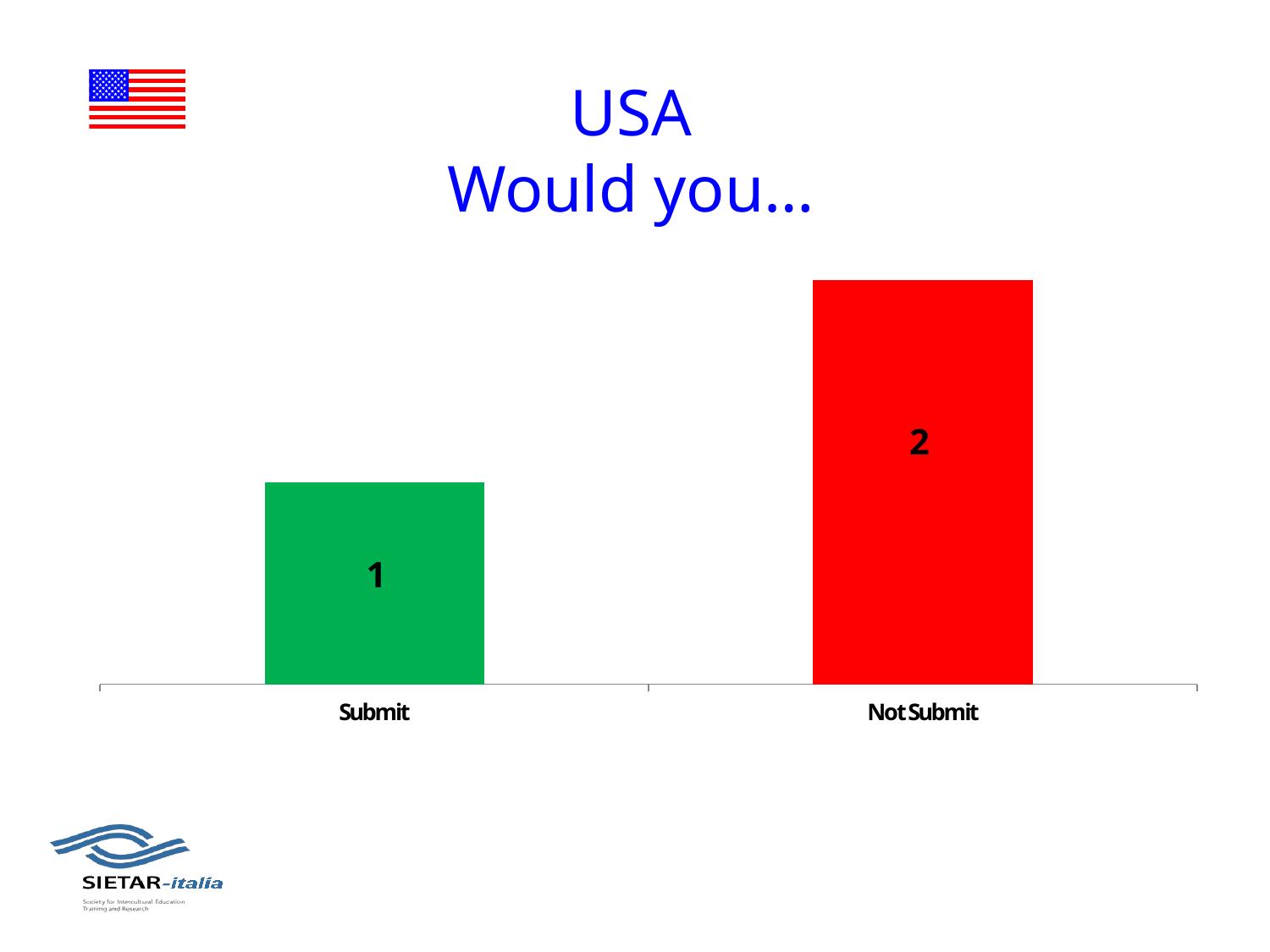
What is the value for Submit? 1 What colour is the bar for Not Submit? red Which category has the lowest value? Submit What colour is the bar for Submit? green Do the values rise or fall from Submit to Not Submit? rise What kind of chart is shown on the slide? bar chart What is the total of the values for Submit and Not Submit? 3 What is the value for Not Submit? 2 How many categories are shown on the x axis? 2 Which is larger, the value for Submit or the value for Not Submit? Not Submit What is the difference between the values for Not Submit and Submit? 1 Which category has the highest value? Not Submit